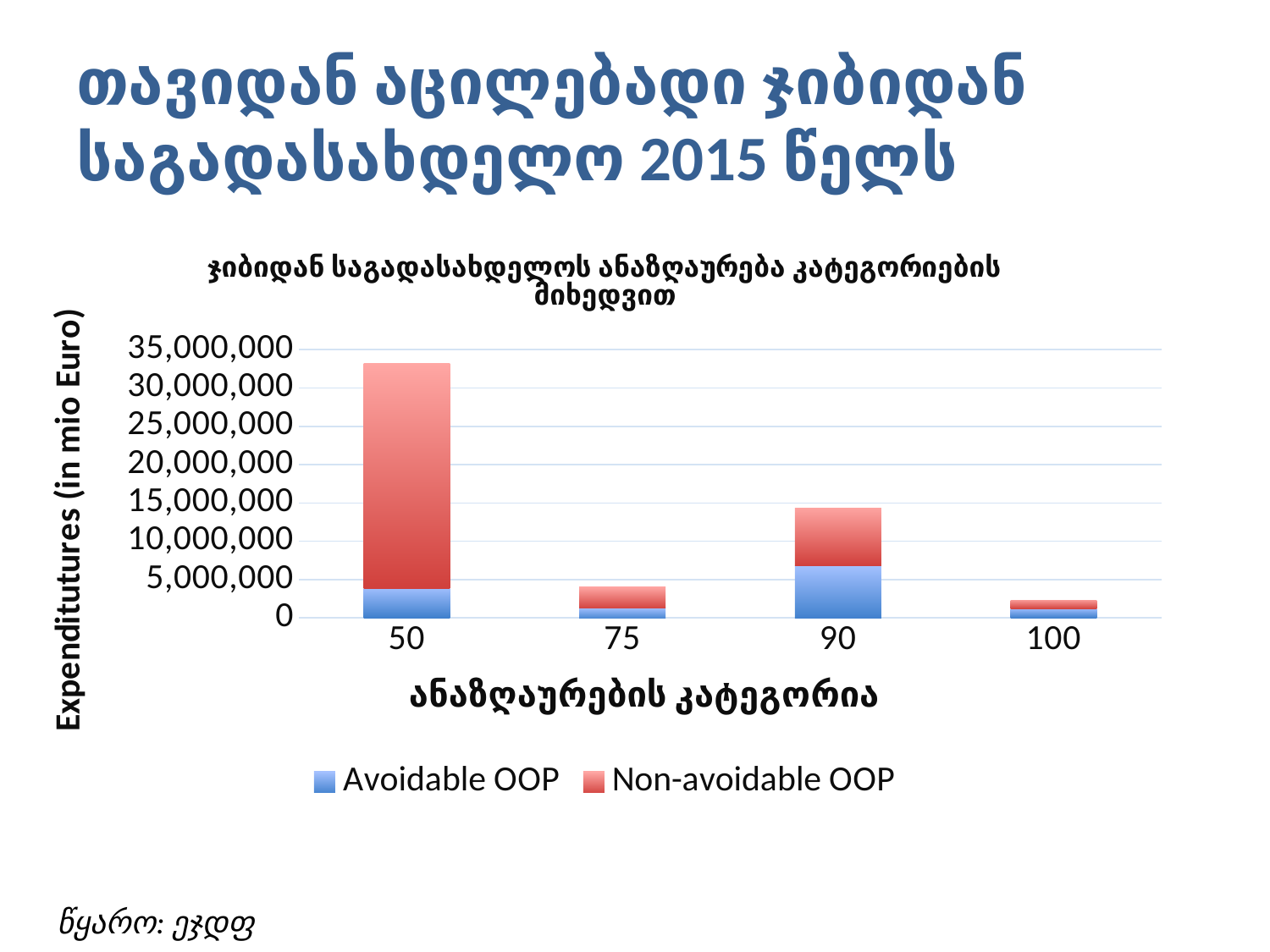
What are the two series listed in the chart's legend? Avoidable OOP and Non-avoidable OOP Is the total value of the bar for category 50 greater or less than 30,000,000? greater How many series does the chart's legend list? 2 Which category has the tallest stacked bar? 50 Which category has the larger total bar, 50 or 90? 50 What is the label of the chart's vertical axis? Expenditutures (in mio Euro) How many categories are shown on the x axis of the chart? 4 Is the Avoidable OOP value for category 90 greater or less than 5,000,000? greater Is the total value of the bar for category 75 greater or less than 5,000,000? less What kind of chart is shown on the slide? stacked bar chart Which category has the shortest stacked bar? 100 Which category has the larger total bar, 75 or 100? 75